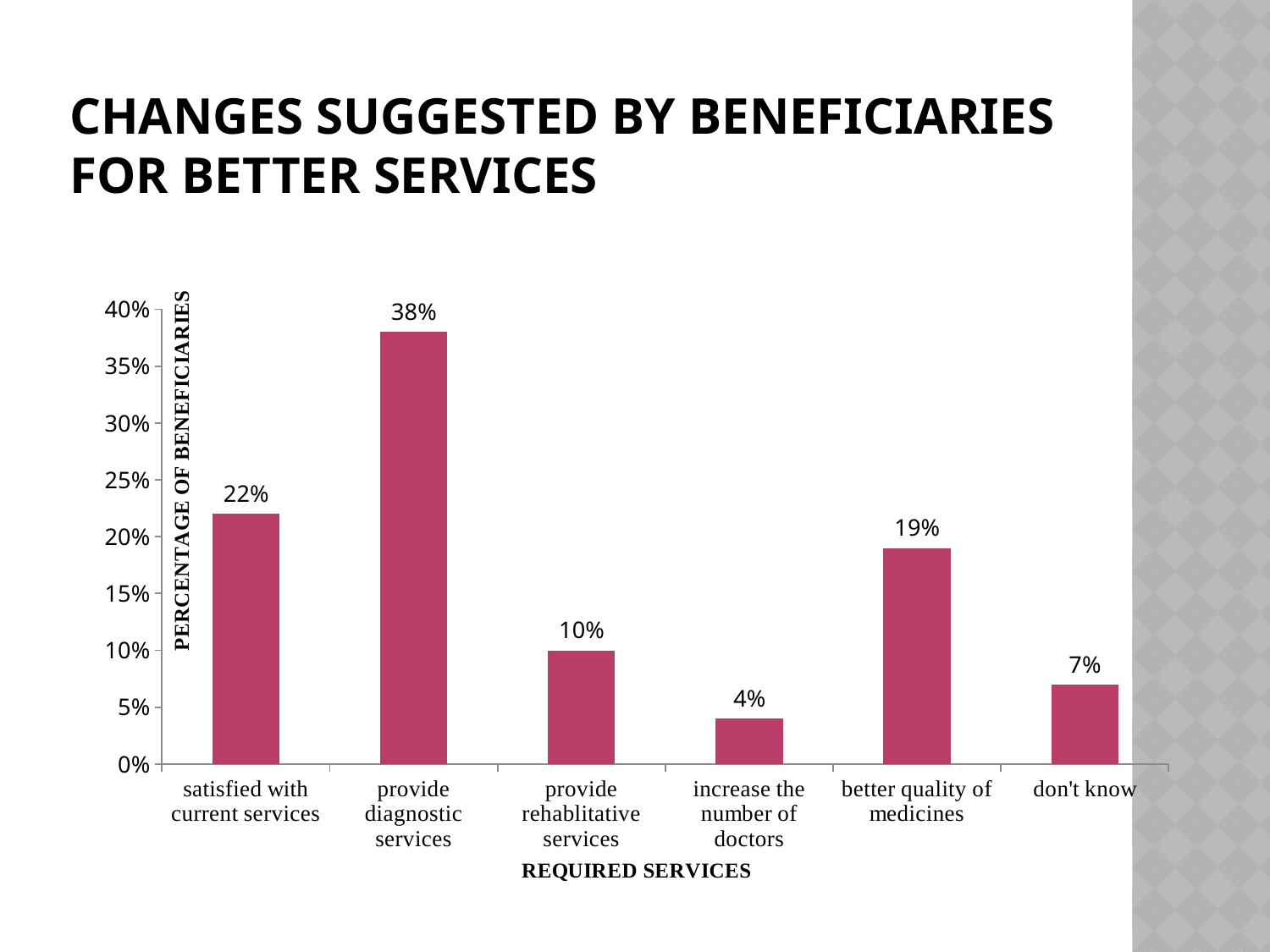
What is the label of the x axis? REQUIRED SERVICES What percentage of beneficiaries suggested providing diagnostic services? 38% Which required service has the highest percentage of beneficiaries? provide diagnostic services What is the value for 'don't know'? 7% What is the value for 'better quality of medicines'? 19% What is the label of the y axis? PERCENTAGE OF BENEFICIARIES What is the difference between 'provide diagnostic services' and 'satisfied with current services'? 16% How many categories are shown on the x axis? 6 What kind of chart is shown on the slide? bar chart What percentage of beneficiaries were satisfied with current services? 22% Which is larger: 'provide rehablitative services' or 'better quality of medicines'? better quality of medicines Which category has the lowest percentage of beneficiaries? increase the number of doctors